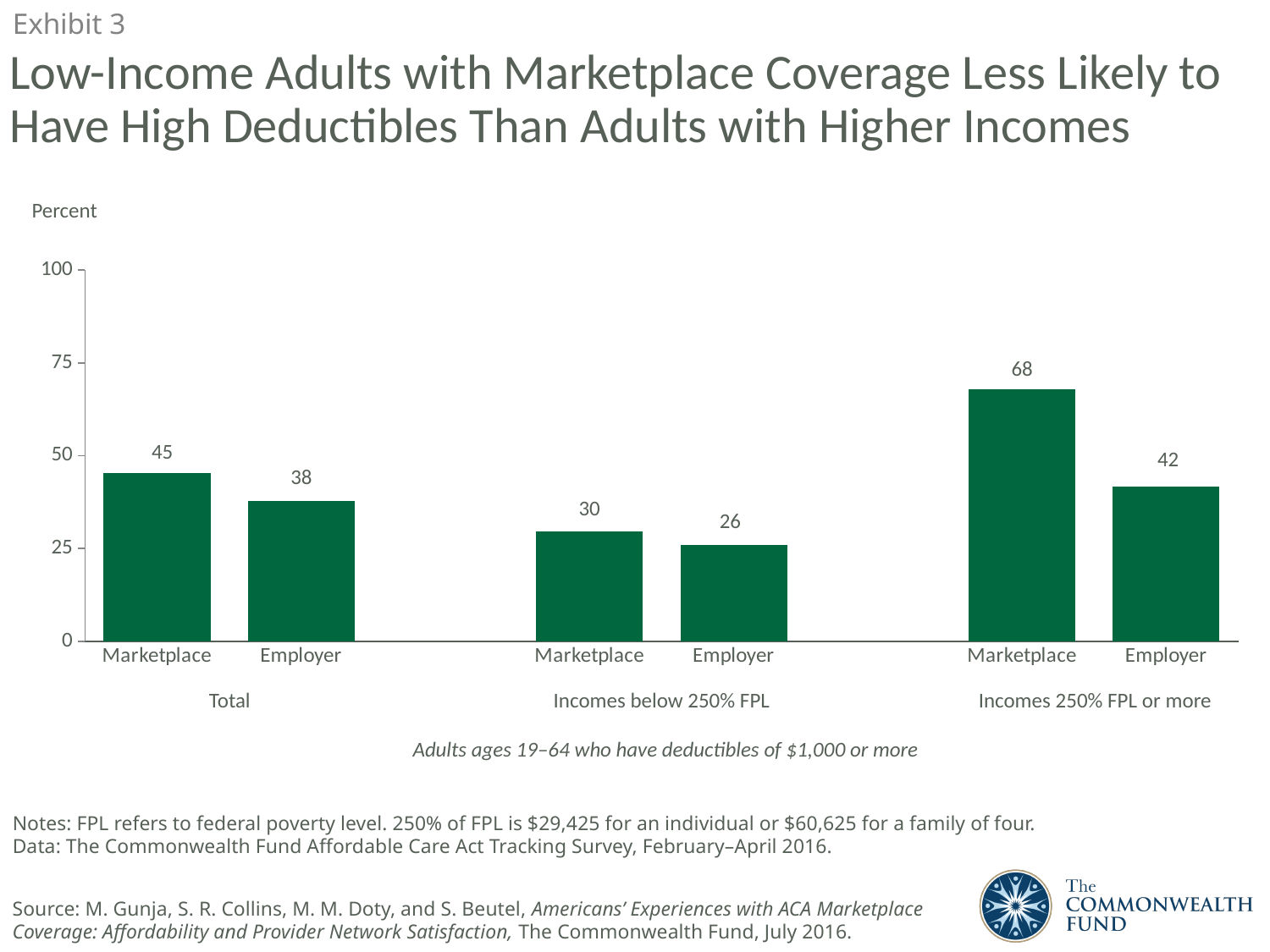
What is the difference between Marketplace and Employer in the Incomes 250% FPL or more group? 26 What kind of chart is shown on the slide? bar chart What is the value for Employer in the Incomes below 250% FPL group? 26 Which is larger: Marketplace in the Incomes below 250% FPL group or Employer in the Total group? Employer in the Total group What is the label on the y axis of the chart? Percent How many bars are plotted on the chart? 6 Which bar has the highest value on the chart? Marketplace, Incomes 250% FPL or more Which bar has the lowest value on the chart? Employer, Incomes below 250% FPL Is the value for Marketplace in the Incomes 250% FPL or more group greater or less than 50? greater What is the value for Marketplace in the Incomes 250% FPL or more group? 68 What is the value for Marketplace in the Total group? 45 What is the difference between Marketplace and Employer in the Total group? 7